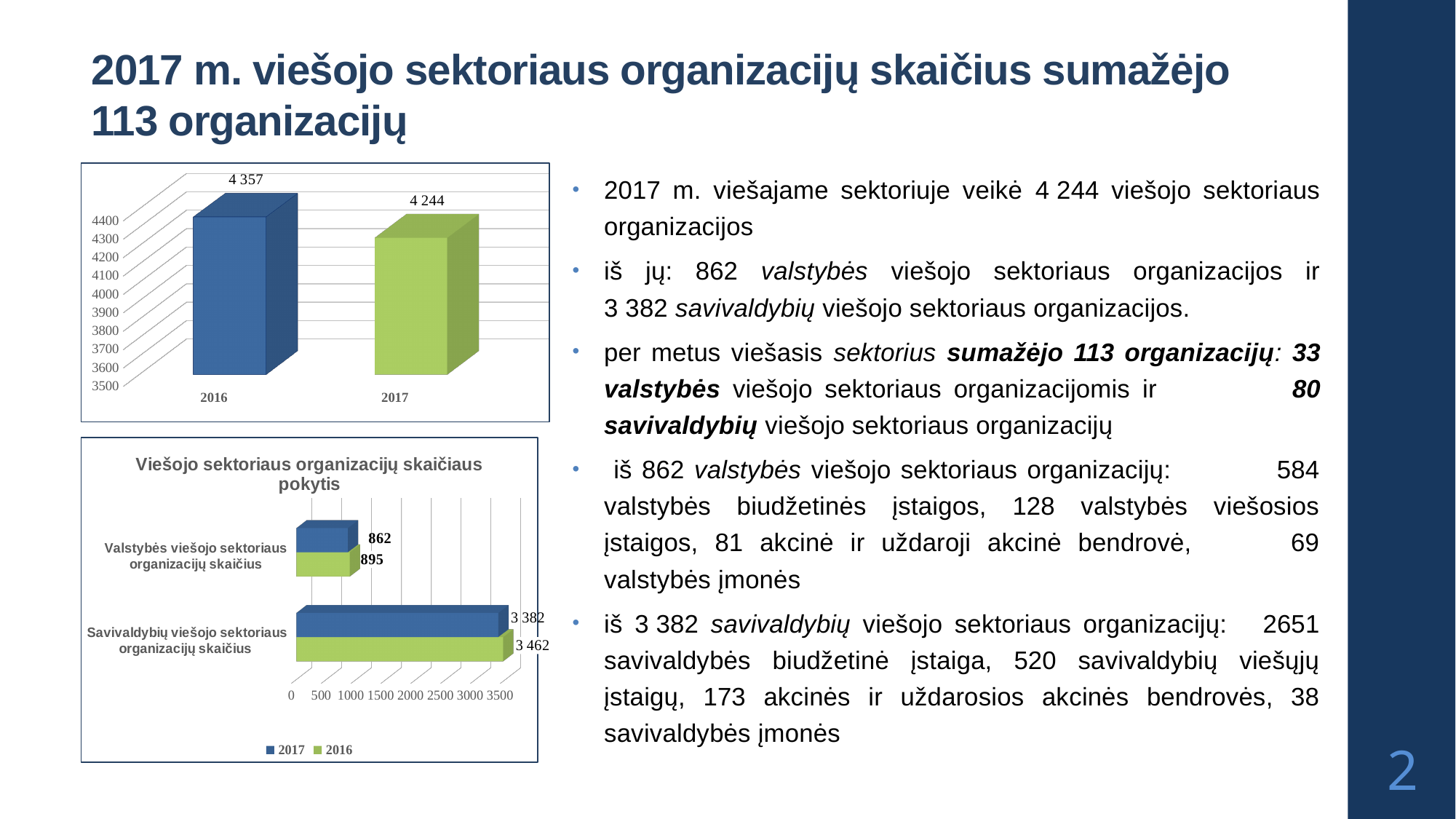
In the top chart, what is the difference between the 2016 and 2017 values? 113 What kind of chart is the top chart? Bar chart In the top chart, how many bars are plotted? 2 In the chart titled 'Viešojo sektoriaus organizacijų skaičiaus pokytis', how many series does the legend list? 2 In the top chart, which year has the higher value? 2016 In the chart titled 'Viešojo sektoriaus organizacijų skaičiaus pokytis', what is the difference between the 2016 and 2017 values for Savivaldybių viešojo sektoriaus organizacijų skaičius? 80 In the top chart, what is the value for 2017? 4 244 In the chart titled 'Viešojo sektoriaus organizacijų skaičiaus pokytis', which category has the lowest 2017 value? Valstybės viešojo sektoriaus organizacijų skaičius In the top chart, what is the value for 2016? 4 357 In the chart titled 'Viešojo sektoriaus organizacijų skaičiaus pokytis', which colour represents the 2016 series? Green In the chart titled 'Viešojo sektoriaus organizacijų skaičiaus pokytis', what is the 2017 value for Valstybės viešojo sektoriaus organizacijų skaičius? 862 In the chart titled 'Viešojo sektoriaus organizacijų skaičiaus pokytis', what is the 2016 value for Savivaldybių viešojo sektoriaus organizacijų skaičius? 3 462